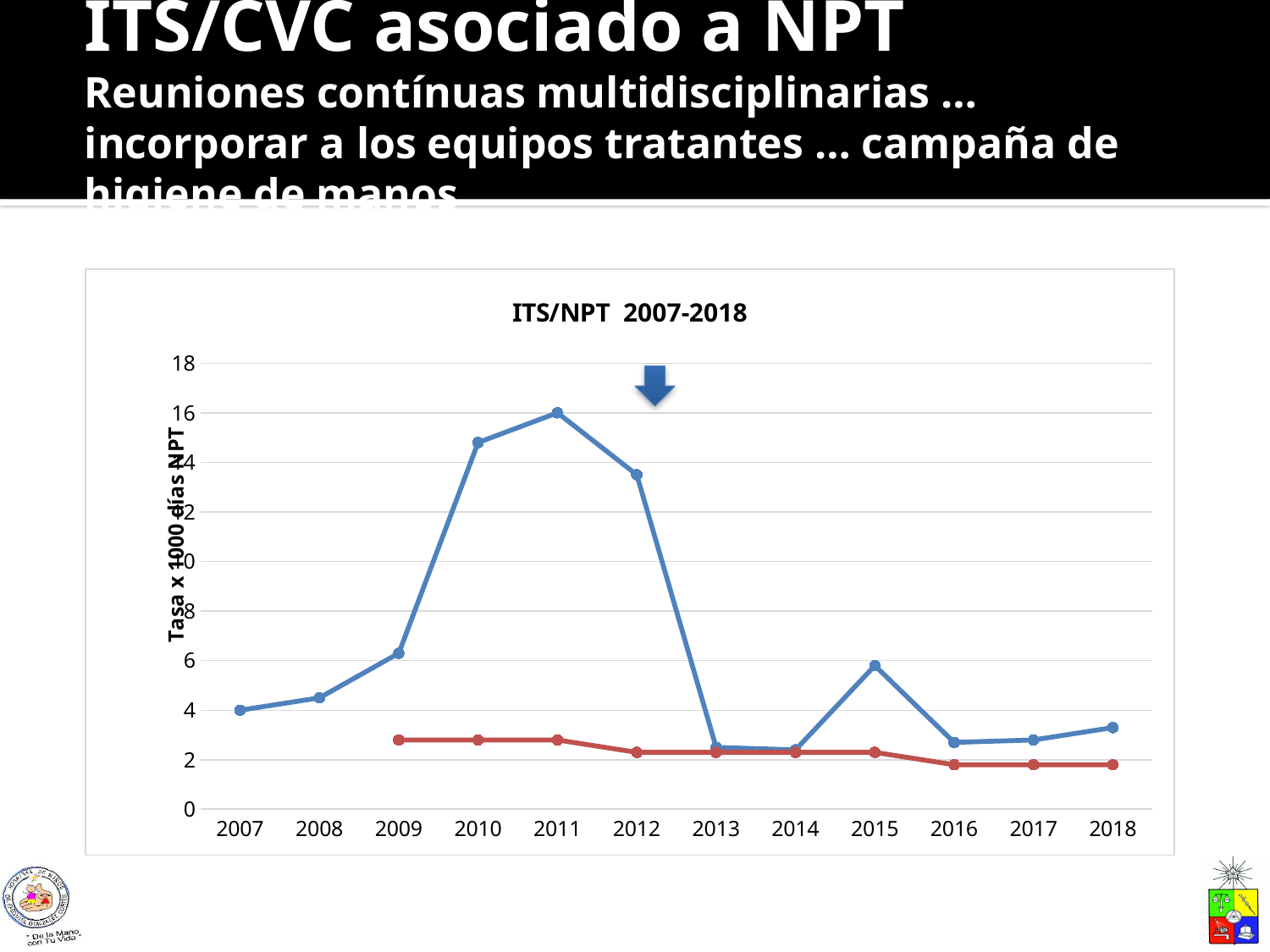
What is the value of the blue line in 2011? 16 Which is larger for the blue line, the value in 2012 or the value in 2015? 2012 What is the label of the vertical axis? Tasa x 1000 días NPT What is the value of the blue line in 2007? 4 How many lines are plotted on the chart? 2 In which year does the blue line reach its highest value? 2011 Is the value of the red line in 2009 greater or less than 2? greater What is the title of the chart? ITS/NPT 2007-2018 Is the value of the blue line in 2010 greater or less than 14? greater Is the value of the blue line in 2013 greater or less than 4? less What kind of chart is shown on the slide? line chart How many years are shown along the x axis? 12